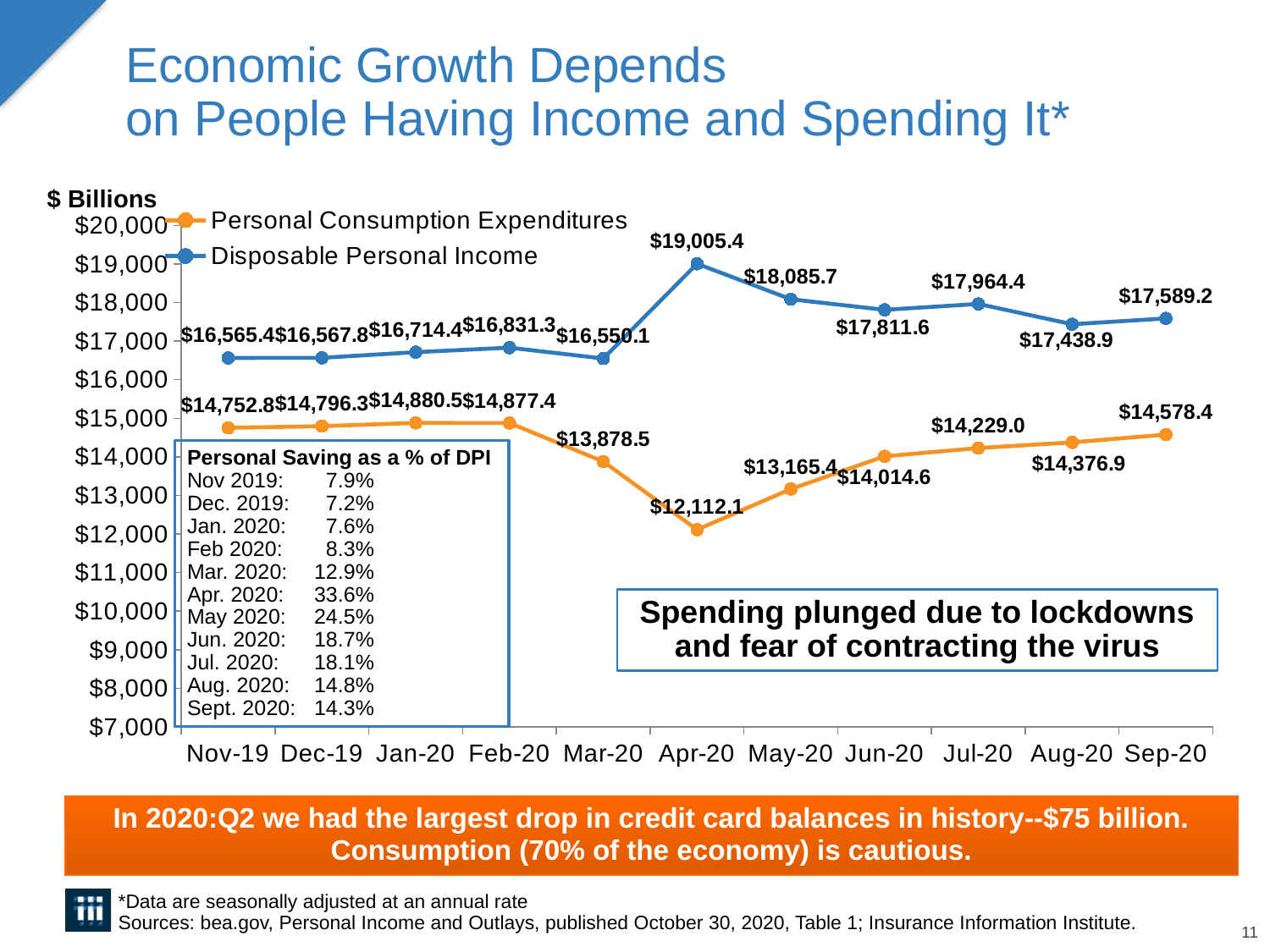
In which month is Disposable Personal Income highest? Apr-20 How many months are plotted along the x axis of the chart? 11 How many series does the chart's legend list? 2 What is the difference between Disposable Personal Income and Personal Consumption Expenditures in Apr-20? $6,893.3 What is the value of Personal Consumption Expenditures in Sep-20? $14,578.4 What unit is shown in the label above the y axis of the chart? $ Billions In which month is Personal Consumption Expenditures lowest? Apr-20 What kind of chart is shown on the slide? Line chart What is the value of Disposable Personal Income in Apr-20? $19,005.4 Does Personal Consumption Expenditures rise or fall from Apr-20 to Sep-20? Rise Which is larger in Mar-20: Disposable Personal Income or Personal Consumption Expenditures? Disposable Personal Income By how much did Personal Consumption Expenditures increase from Aug-20 to Sep-20? $201.5